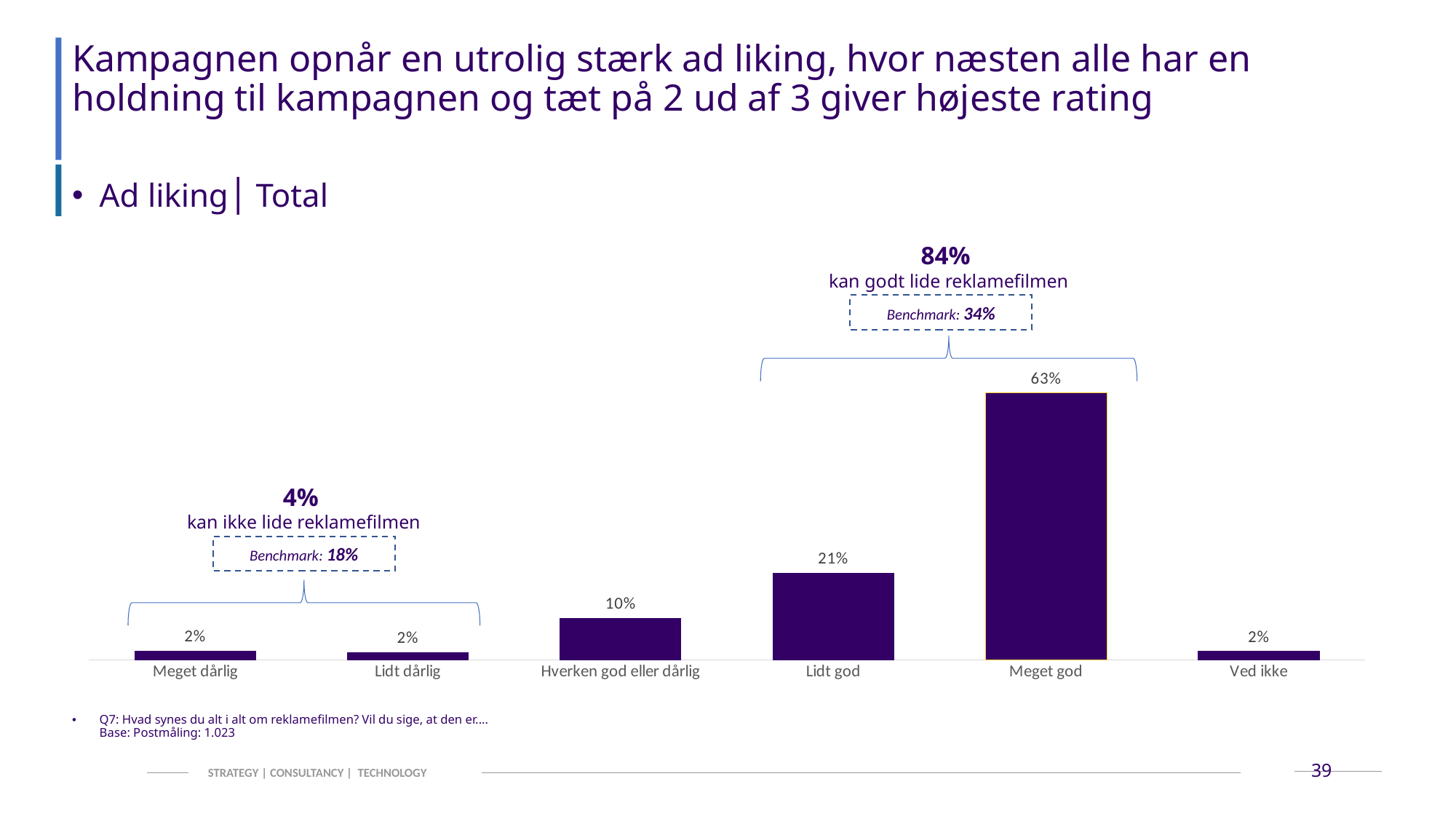
What is the title of the chart section on the slide? Ad liking | Total What is the value for Hverken god eller dårlig? 10% What kind of chart is shown on the slide? Bar chart What is the value for Lidt god? 21% How many categories are shown on the x axis? 6 What is the value for Meget god? 63% What is the difference between the values for Meget god and Lidt god? 42% What is the benchmark value shown for 'kan ikke lide reklamefilmen'? 18% What is the combined share of respondents who like the ad (kan godt lide reklamefilmen), as printed on the slide? 84% Which category has the highest value? Meget god What is the value for Ved ikke? 2% Which is larger, the value for Lidt god or the value for Hverken god eller dårlig? Lidt god